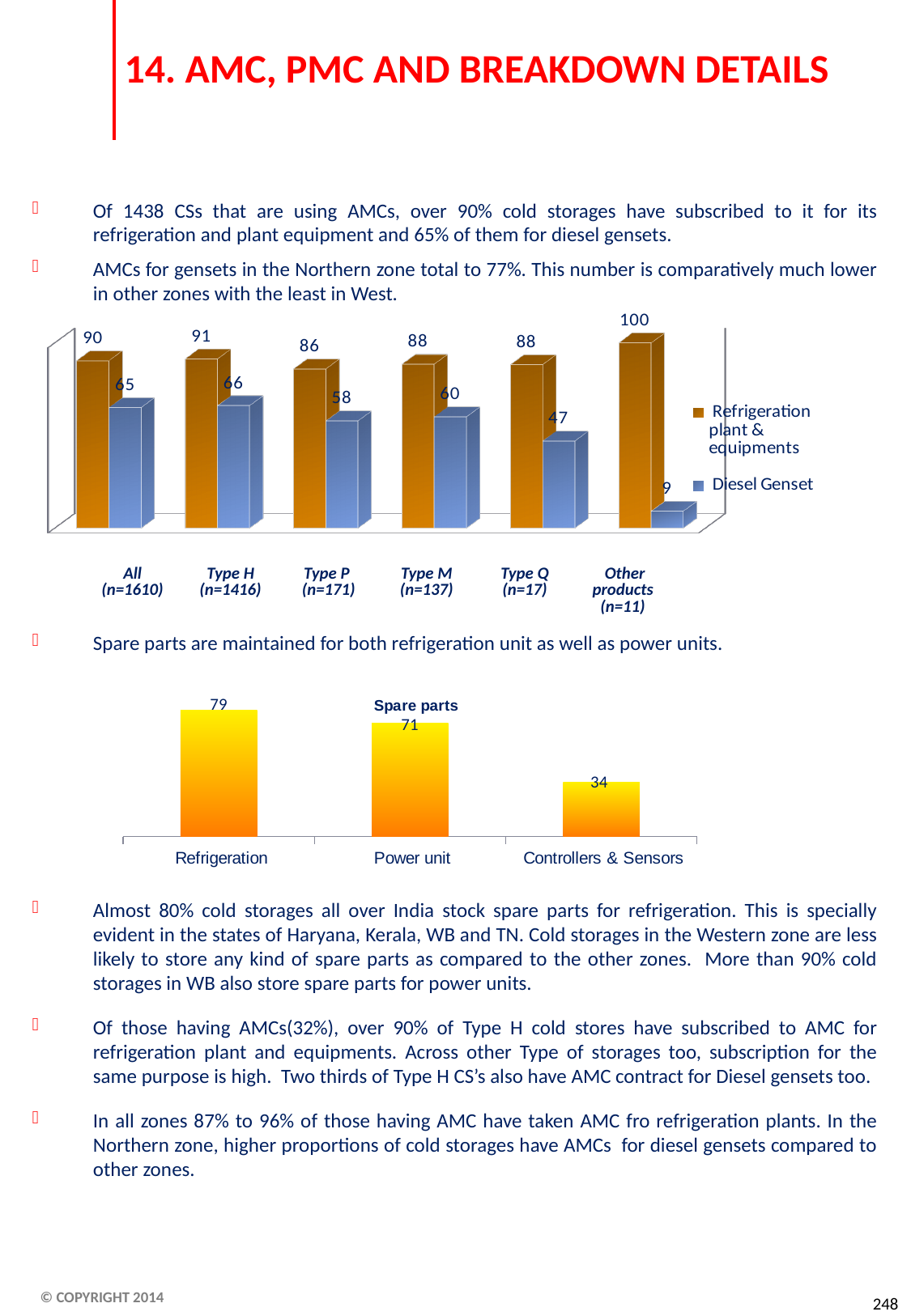
In the top chart, what is the difference between the Refrigeration plant & equipments value and the Diesel Genset value for All (n=1610)? 25 In the top chart, which category has the lowest Diesel Genset value? Other products (n=11) In the top chart, which category has the highest Refrigeration plant & equipments value? Other products (n=11) In the top chart, which is larger for Type M (n=137): Refrigeration plant & equipments or Diesel Genset? Refrigeration plant & equipments What kind of chart is the Spare parts chart? Bar chart In the Spare parts chart, what is the difference between Refrigeration and Controllers & Sensors? 45 In the top chart, what is the Diesel Genset value for Type Q (n=17)? 47 In the Spare parts chart, what is the value for Power unit? 71 How many categories are shown on the x axis of the top chart? 6 How many series does the legend of the top chart list? 2 In the Spare parts chart, which category has the lowest value? Controllers & Sensors In the top chart, what is the value for Refrigeration plant & equipments for Type P (n=171)? 86